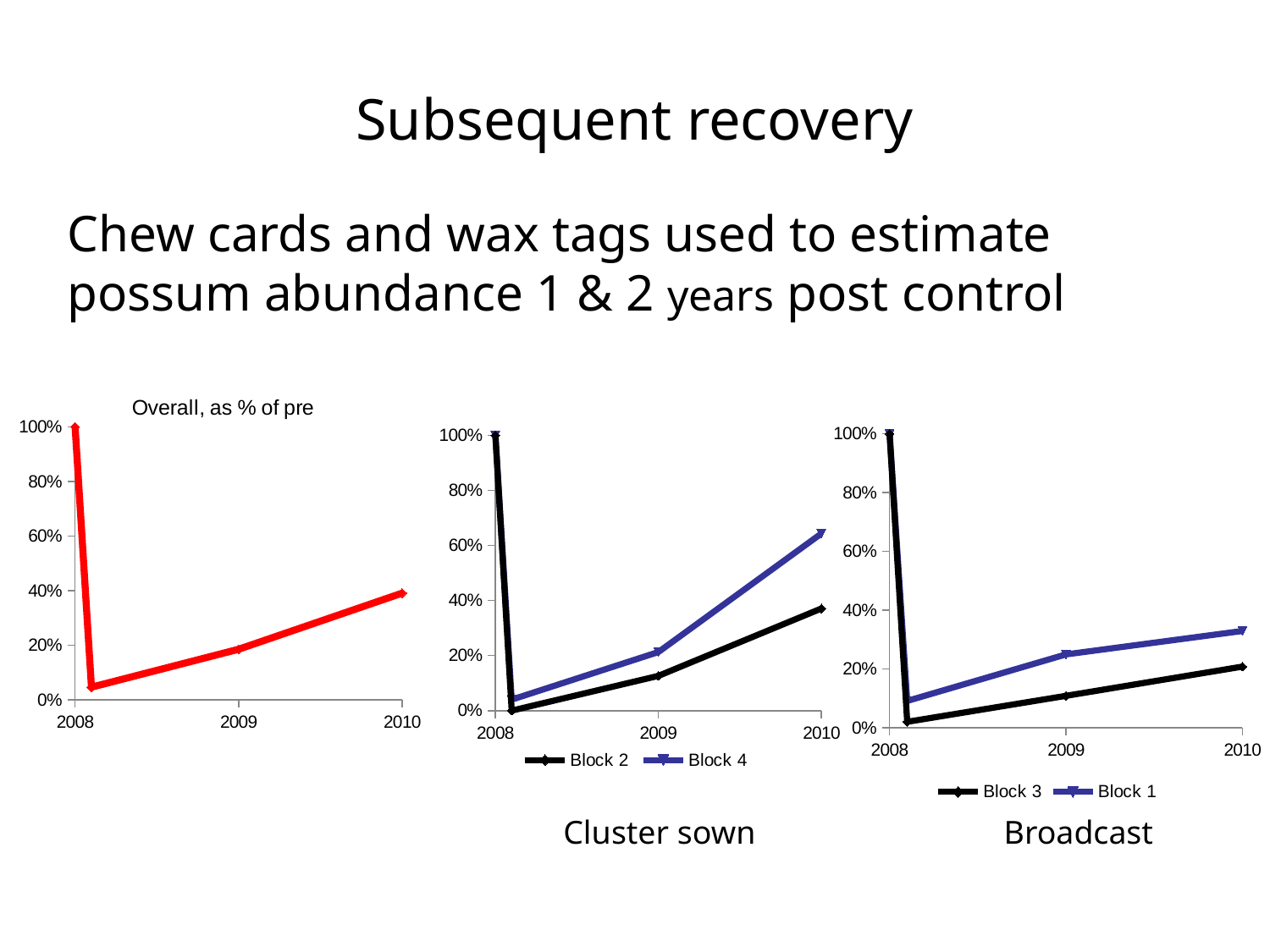
In the 'Overall, as % of pre' chart, do the values rise or fall from 2009 to 2010? rise How many series does the legend of the 'Cluster sown' chart list? 2 In the 'Cluster sown' chart, which series has the higher value in 2010, Block 2 or Block 4? Block 4 In the 'Overall, as % of pre' chart, is the value for 2010 greater or less than 20%? greater In the 'Cluster sown' chart, is the value for Block 2 in 2010 greater or less than 40%? less How many years are labelled on the x axis of the 'Broadcast' chart? 3 In the 'Broadcast' chart, is the value for Block 3 in 2009 greater or less than 20%? less What type of chart is the 'Overall, as % of pre' chart on the left? line chart In the 'Broadcast' chart, which series has the higher value in 2010, Block 3 or Block 1? Block 1 In the 'Overall, as % of pre' chart, what is the value at the start of 2008? 100%